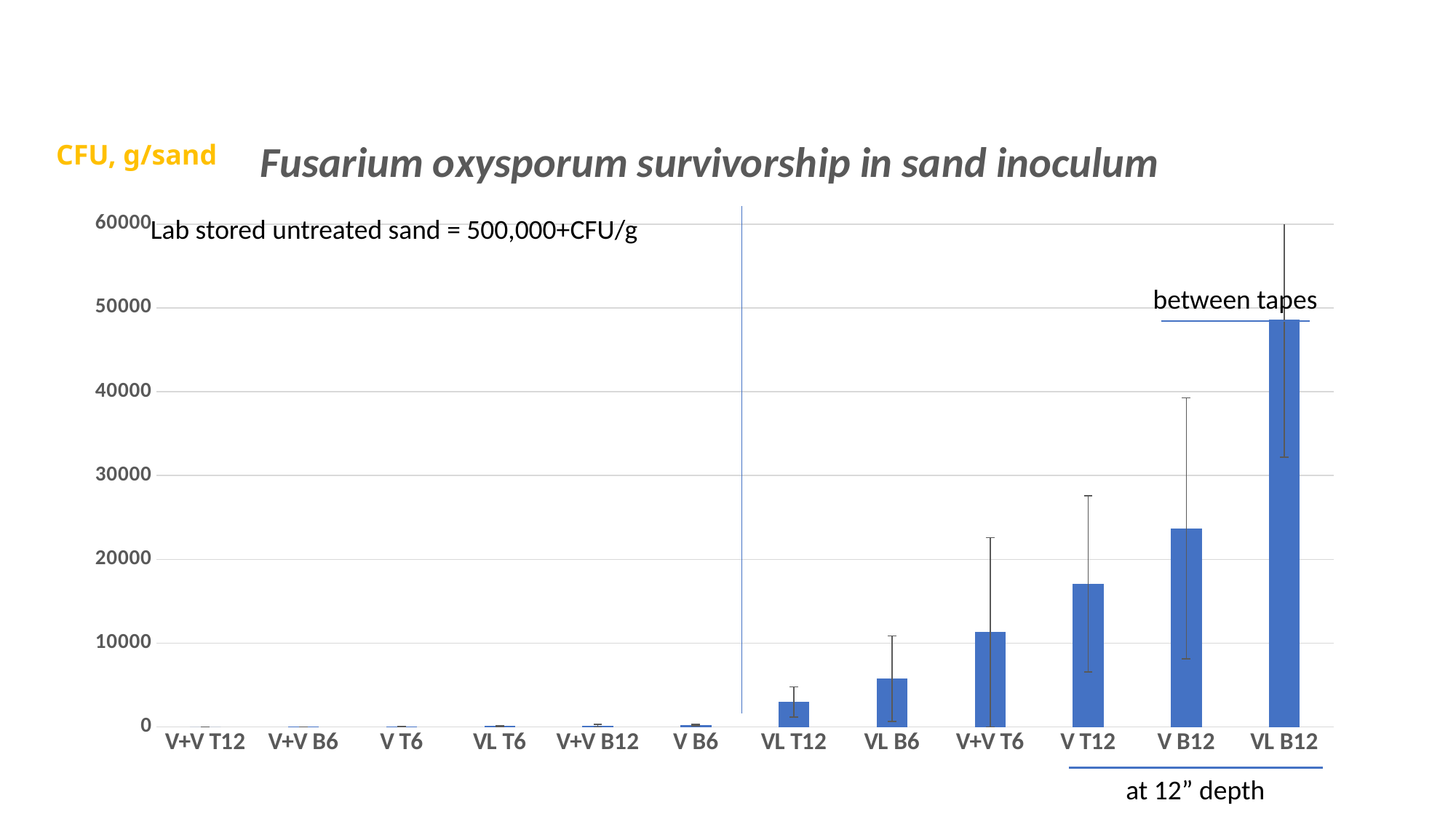
Is the value for VL B12 greater or less than 40000? greater What kind of chart is shown on the slide? bar chart How many categories are plotted along the x axis? 12 Which is larger, the value for V T12 or the value for VL B6? V T12 What is the title of the chart? Fusarium oxysporum survivorship in sand inoculum Which is larger, the value for VL B12 or the value for V B12? VL B12 Is the value for VL T12 greater or less than 10000? less Is the value for V T12 greater or less than 20000? less Which category has the highest value? VL B12 Do the bar values generally rise or fall from left to right along the x axis? rise